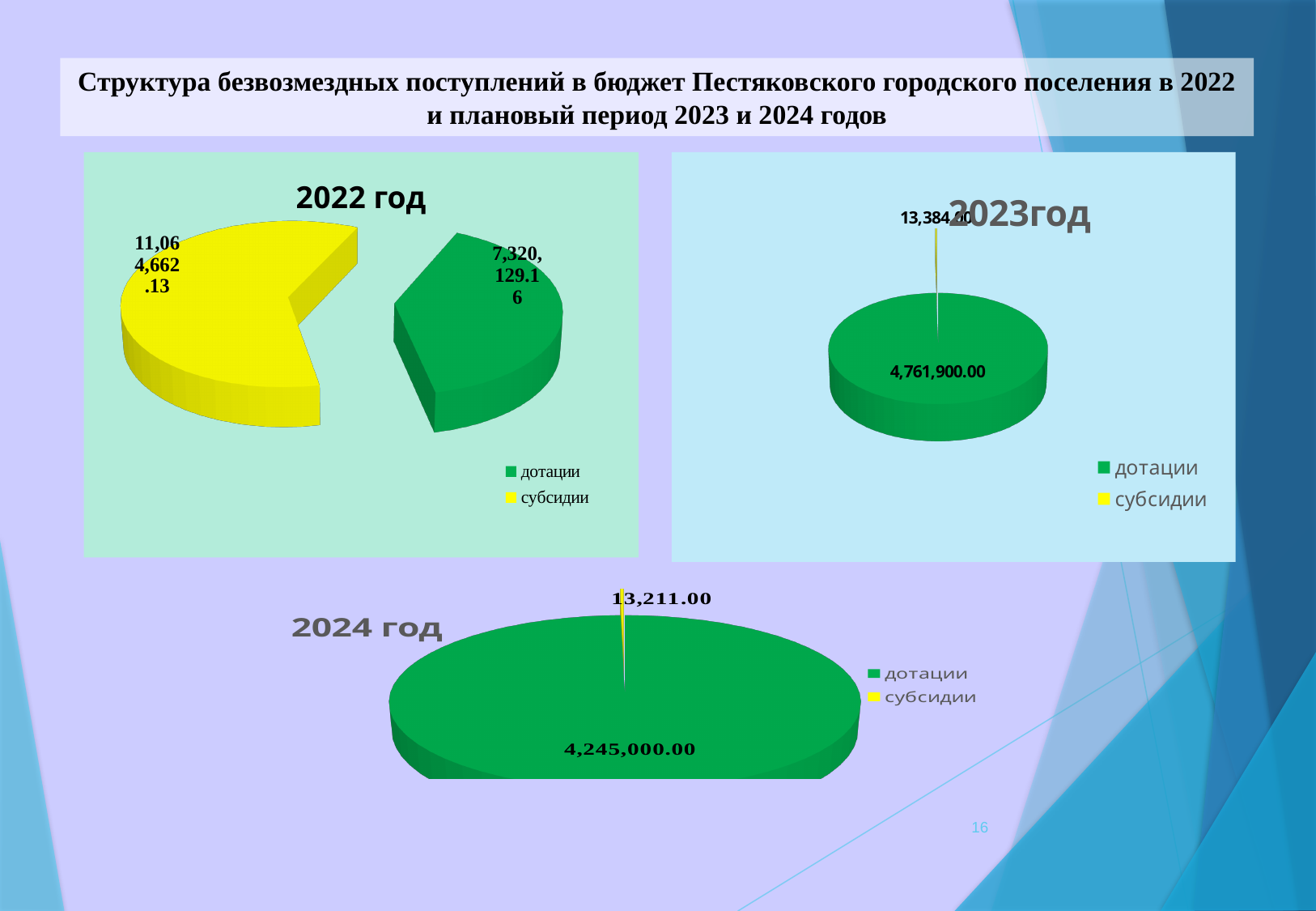
In the 2024 год chart, is дотации or субсидии larger? дотации In the 2024 год chart, what is the value for субсидии? 13,211.00 In the 2022 год chart, what is the value for субсидии? 11,064,662.13 In the 2023год chart, what is the value for субсидии? 13,384.00 In the 2022 год chart, which category has the larger value? субсидии How many entries does the legend of the 2023год chart list? 2 In the 2024 год chart, what is the value for дотации? 4,245,000.00 What type of chart is the 2024 год chart? pie chart In the 2022 год chart, what is the difference between субсидии and дотации? 3,744,532.97 In the 2023год chart, what is the value for дотации? 4,761,900.00 In the 2022 год chart, what is the value for дотации? 7,320,129.16 In the 2023год chart, which category has the smallest value? субсидии